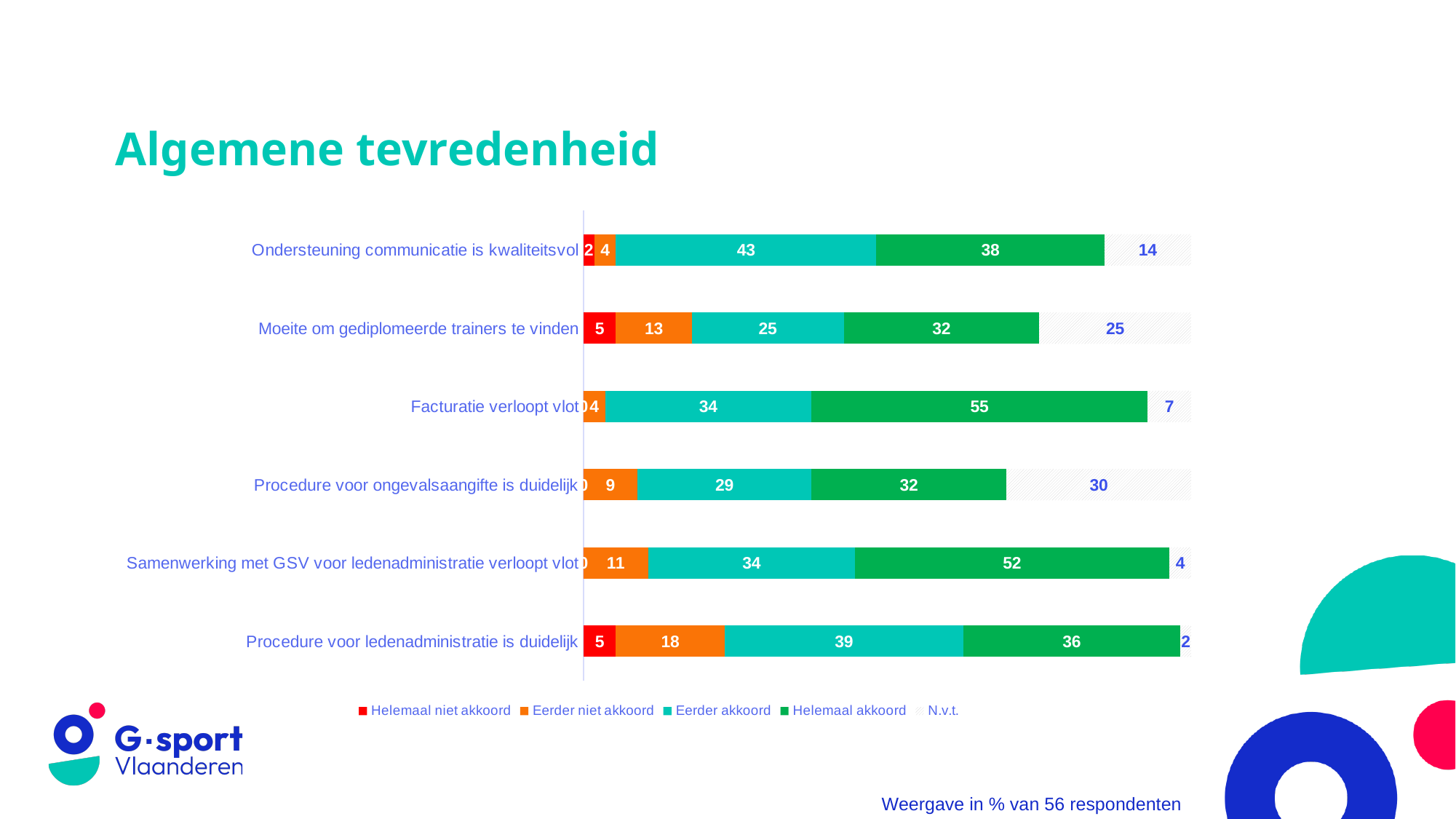
Which category has the highest 'Helemaal akkoord' value? Facturatie verloopt vlot Which category has the highest 'Eerder niet akkoord' value? Procedure voor ledenadministratie is duidelijk Which category has the lowest 'N.v.t.' value? Procedure voor ledenadministratie is duidelijk Which has the larger 'Helemaal akkoord' value: 'Samenwerking met GSV voor ledenadministratie verloopt vlot' or 'Procedure voor ledenadministratie is duidelijk'? Samenwerking met GSV voor ledenadministratie verloopt vlot How many categories (statements) are shown in the chart? 6 What is the difference between the 'Eerder akkoord' values for 'Ondersteuning communicatie is kwaliteitsvol' and 'Moeite om gediplomeerde trainers te vinden'? 18 How many series does the legend list? 5 What type of chart is shown on the slide? Stacked bar chart What is the 'N.v.t.' value for 'Procedure voor ongevalsaangifte is duidelijk'? 30 What is the value for 'Helemaal akkoord' in the 'Facturatie verloopt vlot' bar? 55 What is the 'Eerder akkoord' value for 'Samenwerking met GSV voor ledenadministratie verloopt vlot'? 34 What is the 'Eerder niet akkoord' value for 'Procedure voor ledenadministratie is duidelijk'? 18